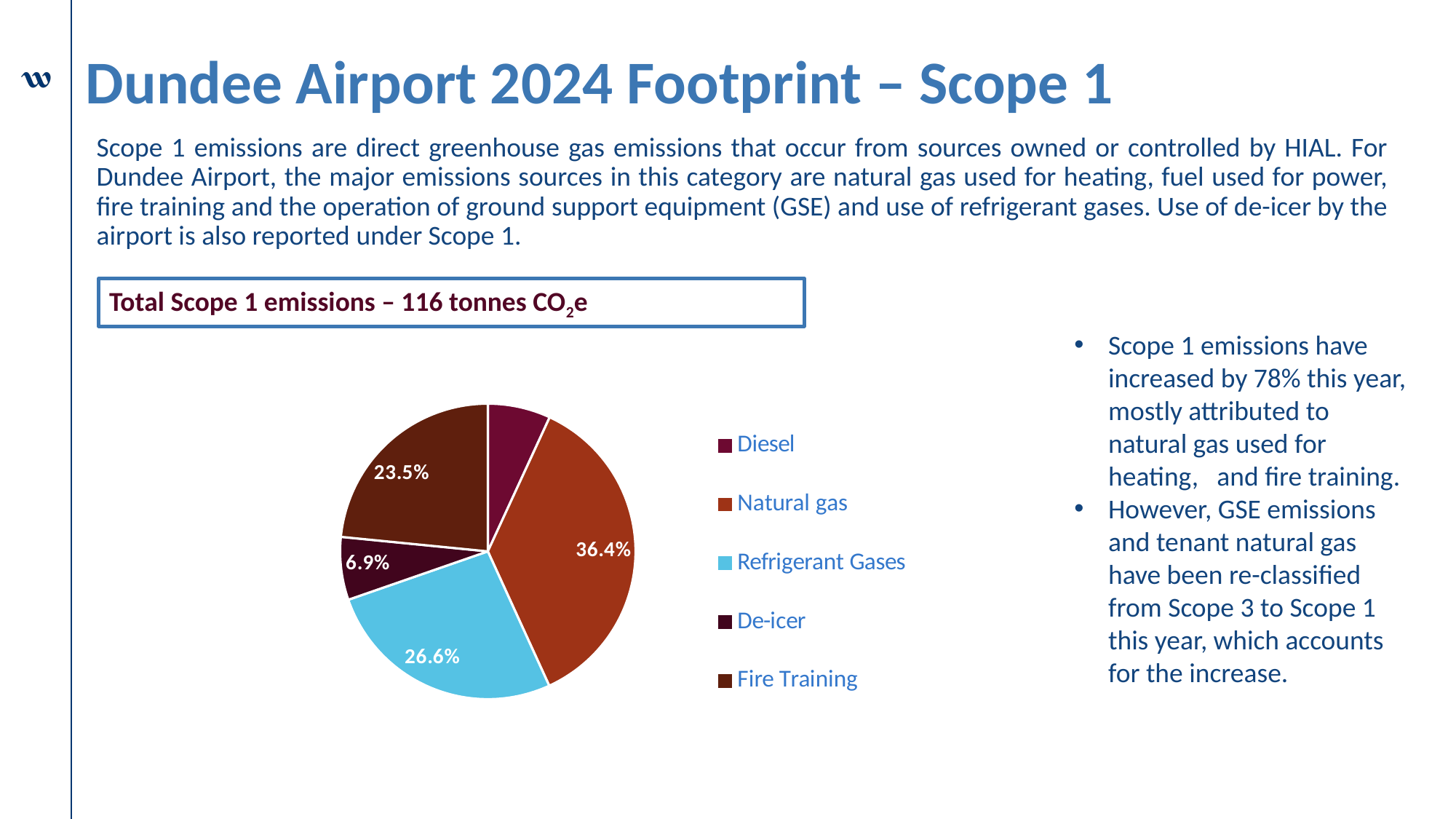
What colour represents Refrigerant Gases in the pie chart? Light blue What percentage is shown for De-icer in the pie chart? 6.9% What is the difference in percentage points between Fire Training and De-icer? 16.6 percentage points Which slice is larger, Fire Training or Refrigerant Gases? Refrigerant Gases What percentage of the pie chart is Refrigerant Gases? 26.6% How many categories are shown in the pie chart? 5 What is the difference in percentage points between Refrigerant Gases and Fire Training? 3.1 percentage points What percentage is shown for Fire Training in the pie chart? 23.5% What type of chart is shown on the slide? Pie chart How many percentage points larger is the Natural gas slice than the Refrigerant Gases slice? 9.8 percentage points What share of Scope 1 emissions does Natural gas account for in the pie chart? 36.4% Which category has the largest slice of the pie chart? Natural gas